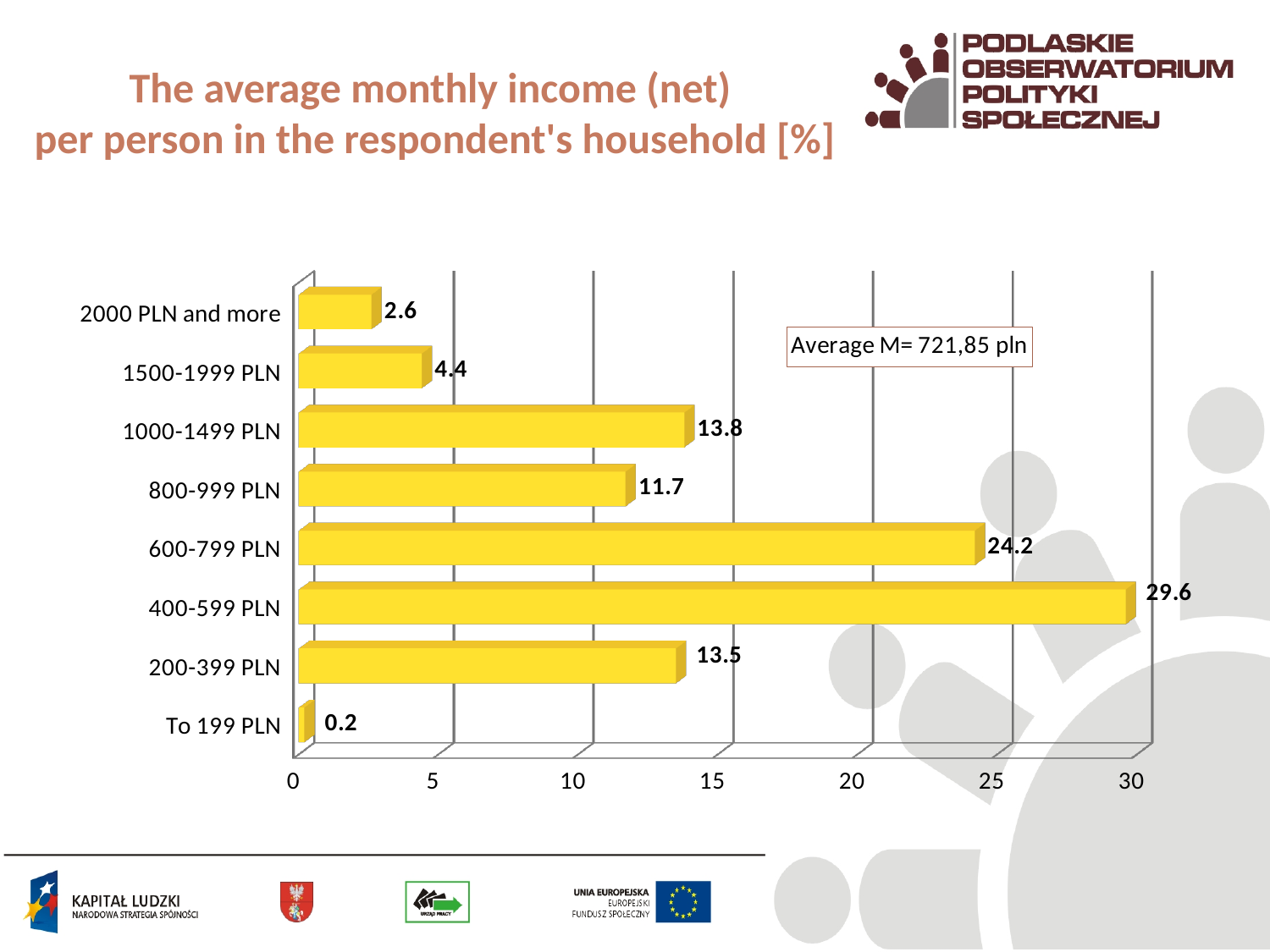
Which is larger, the value for 800-999 PLN or the value for 200-399 PLN? 200-399 PLN What average value is stated in the text box on the chart? Average M= 721,85 pln What is the difference between the values for 1500-1999 PLN and 2000 PLN and more? 1.8 Which income category has the lowest value? To 199 PLN Which income category has the highest value? 400-599 PLN What is the maximum value shown on the horizontal axis? 30 What kind of chart is shown on the slide? bar chart How many income categories are shown in the chart? 8 What is the difference between the values for 400-599 PLN and 600-799 PLN? 5.4 What is the value for the 400-599 PLN category? 29.6 What is the value for the 1000-1499 PLN category? 13.8 What is the value for the To 199 PLN category? 0.2